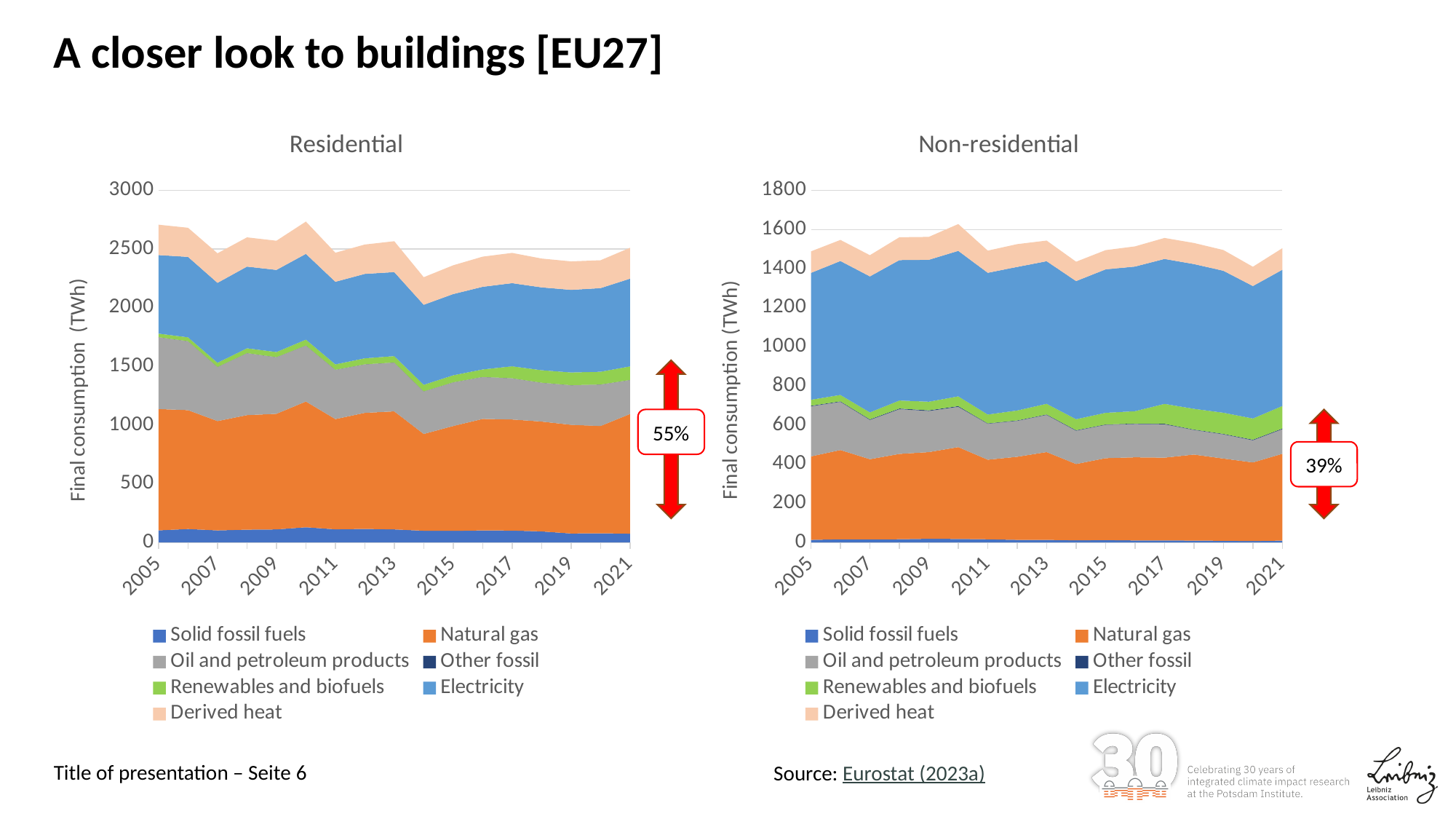
How many series does the legend of the Non-residential chart list? 7 In the Residential chart, is the total final consumption in 2005 greater or less than 2500 TWh? greater What kind of chart is the Residential chart? Stacked area chart What is the highest value shown on the y axis of the Non-residential chart? 1800 In the Non-residential chart, which year has the highest total final consumption? 2010 What percentage is shown in the annotation next to the Non-residential chart? 39% In the Residential chart, which year has the lowest total final consumption? 2014 What percentage is shown in the annotation next to the Residential chart? 55% How many years are plotted along the x axis of the Residential chart? 17 In the Residential chart, is the total final consumption in 2014 greater or less than 2500 TWh? less In the Non-residential chart, is the total final consumption in 2010 greater or less than 1500 TWh? greater In the Residential chart, does the total final consumption rise or fall between 2005 and 2021? fall